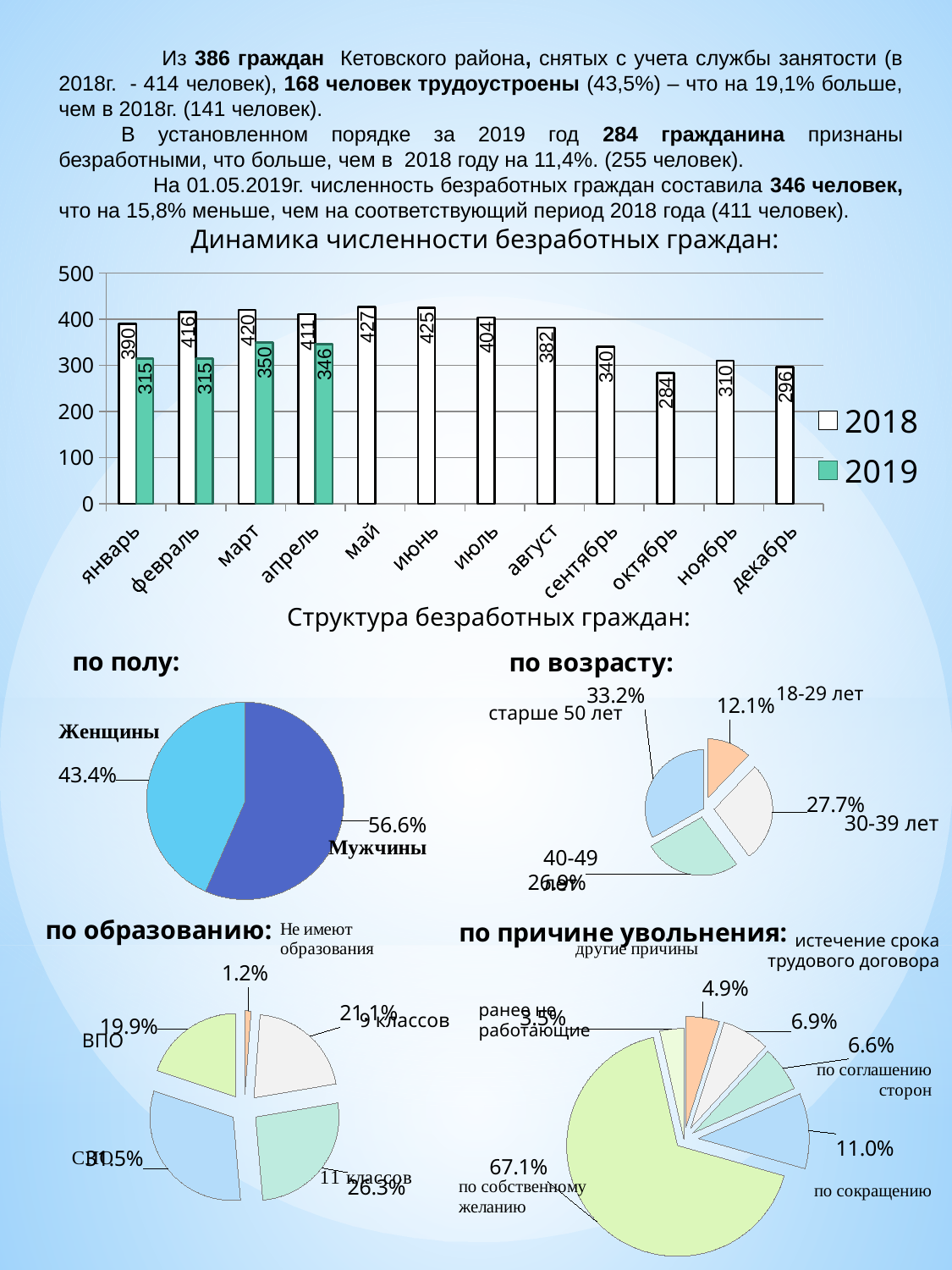
In the bar chart 'Динамика численности безработных граждан', what is the difference between the 2018 and 2019 values for февраль? 101 In the pie chart 'по образованию', which category has the smallest share? Не имеют образования In the pie chart 'по возрасту', what share is 18-29 лет? 12.1% In the bar chart 'Динамика численности безработных граждан', how many months are shown on the x axis? 12 In the bar chart 'Динамика численности безработных граждан', which month has the lowest 2018 value? октябрь In the pie chart 'по причине увольнения', what share is по сокращению? 11.0% In the bar chart 'Динамика численности безработных граждан', what is the 2019 value for март? 350 In the pie chart 'по полу', what share is Мужчины? 56.6% In the bar chart 'Динамика численности безработных граждан', how many series does the legend list? 2 What type of chart is 'Динамика численности безработных граждан'? bar chart In the bar chart 'Динамика численности безработных граждан', what is the 2018 value for май? 427 In the bar chart 'Динамика численности безработных граждан', which month has the highest 2018 value? май